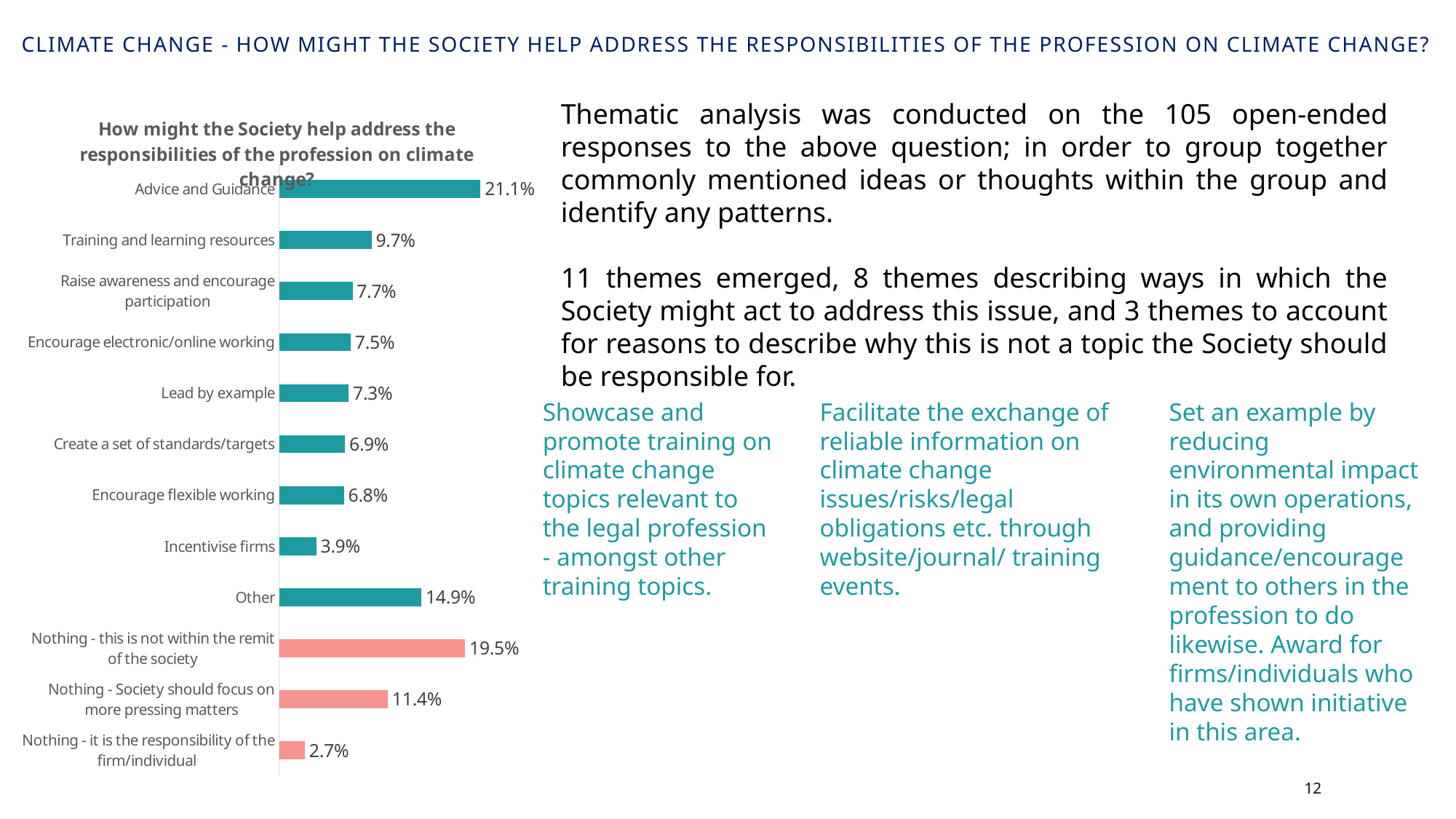
How many categories are shown in the chart? 12 What is the value for Other? 14.9% What is the difference between Lead by example and Encourage flexible working? 0.5% Which category has the highest value? Advice and Guidance What is the value for Nothing - Society should focus on more pressing matters? 11.4% What kind of chart is shown on the slide? Bar chart What is the value for Incentivise firms? 3.9% What is the value for Advice and Guidance? 21.1% Which is larger, Training and learning resources or Raise awareness and encourage participation? Training and learning resources How many bars are coloured pink/red rather than teal? 3 Which category has the lowest value? Nothing - it is the responsibility of the firm/individual What is the difference between Advice and Guidance and Nothing - this is not within the remit of the society? 1.6%